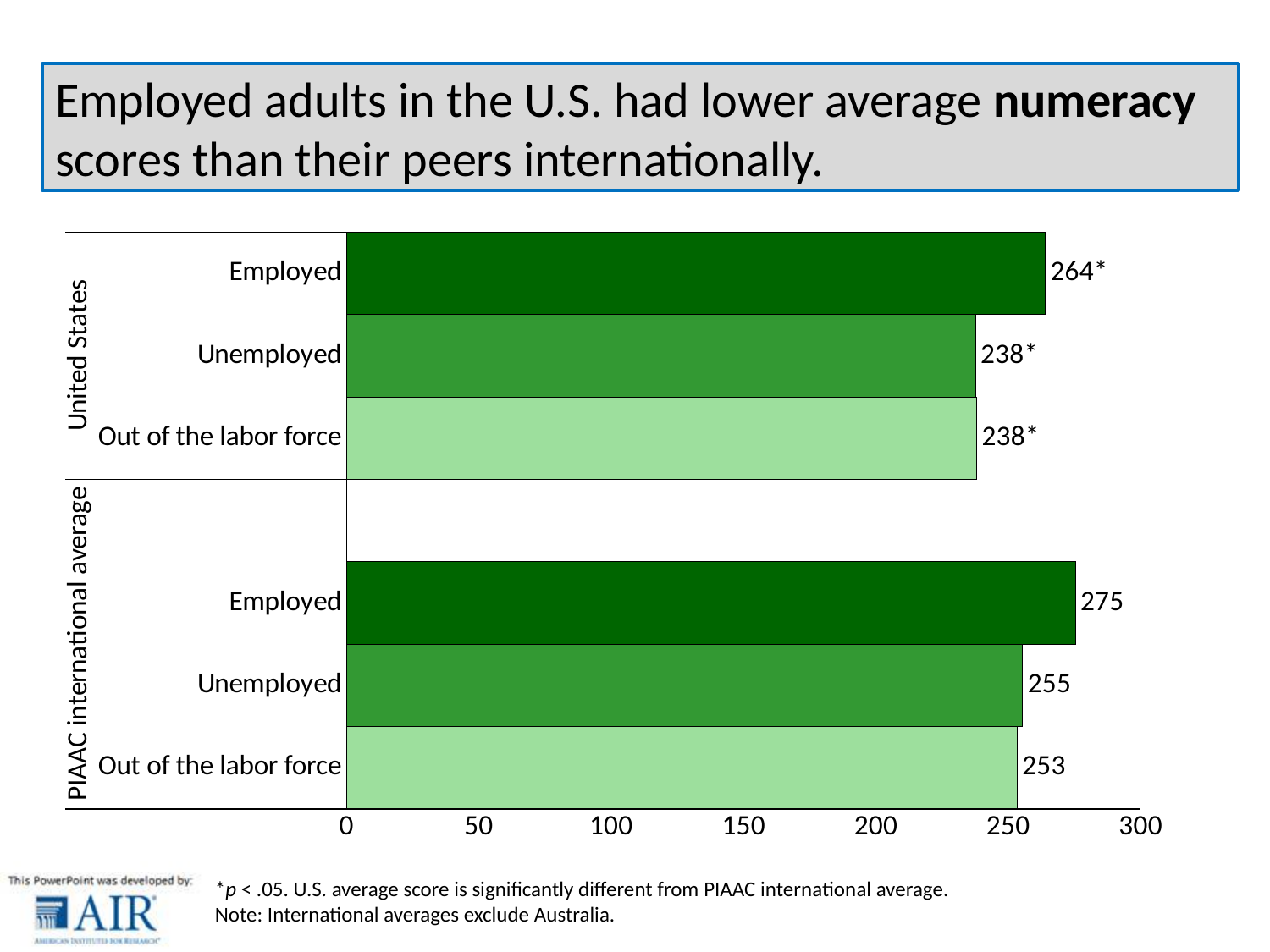
What is the maximum value shown on the horizontal axis? 300 What is the average numeracy score for adults Out of the labor force in the PIAAC international average group? 253 How many bars are plotted on the chart? 6 Is the value for Employed adults in the United States greater or less than 250? greater What is the difference between the Employed score for the PIAAC international average and the Employed score for the United States? 11 Which is larger: the Out of the labor force score for the United States or for the PIAAC international average? PIAAC international average What is the difference between the Unemployed score for the PIAAC international average and the Unemployed score for the United States? 17 What is the average numeracy score for Unemployed adults in the PIAAC international average group? 255 Which bar has the highest value on the chart? PIAAC international average, Employed What kind of chart is shown on the slide? Bar chart What is the average numeracy score for Employed adults in the United States? 264* What is the average numeracy score for Unemployed adults in the United States? 238*